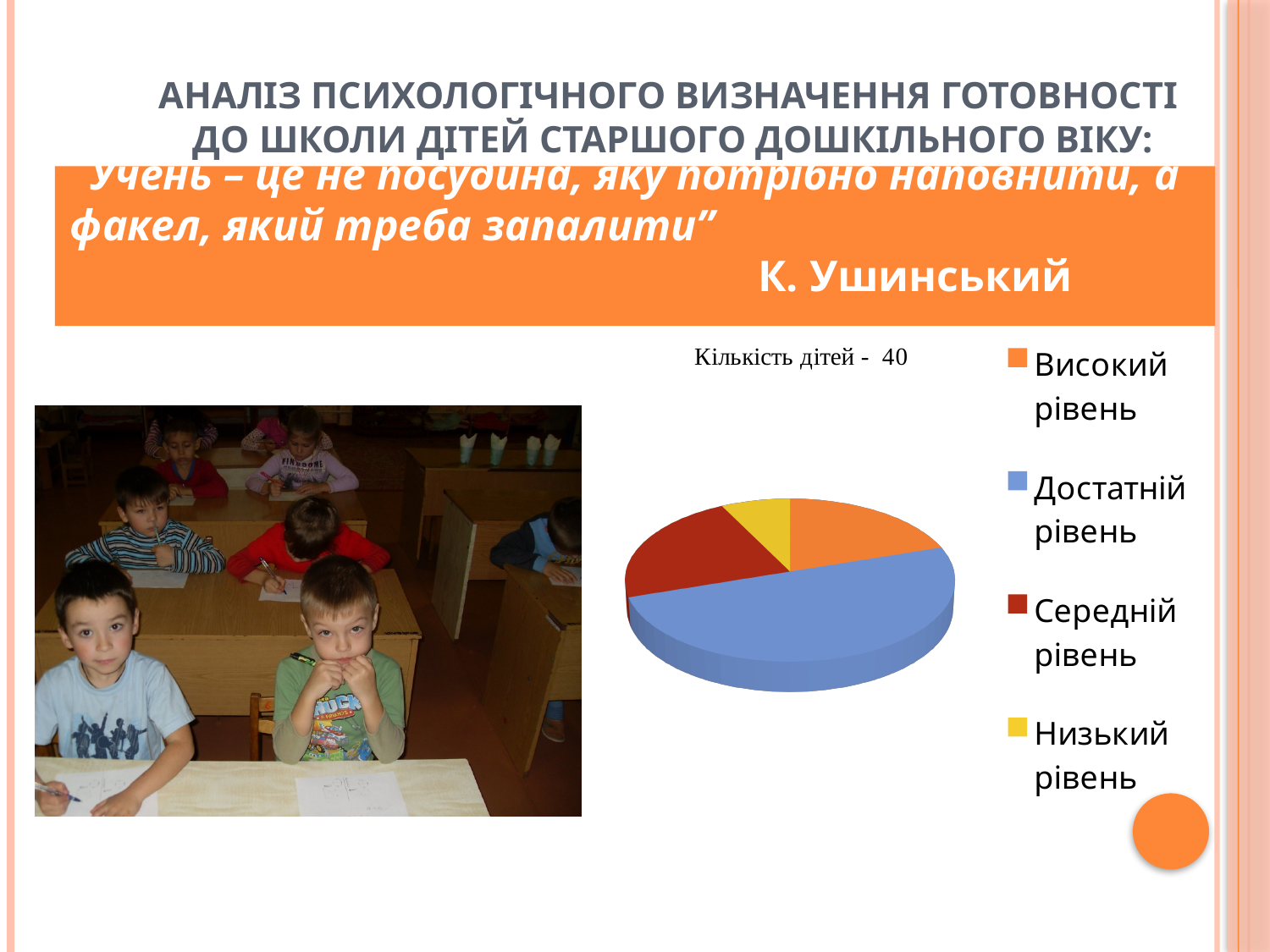
What colour represents Достатній рівень in the pie chart? blue Which slice is larger in the pie chart: Високий рівень or Низький рівень? Високий рівень Which slice is larger in the pie chart: Середній рівень or Низький рівень? Середній рівень Which category has the largest slice in the pie chart? Достатній рівень Which slice is larger in the pie chart: Достатній рівень or Високий рівень? Достатній рівень What kind of chart is shown on the slide? pie chart How many slices does the pie chart have? 4 How many entries does the legend of the pie chart list? 4 Which category has the smallest slice in the pie chart? Низький рівень What text is shown above the pie chart indicating the number of children? Кількість дітей - 40